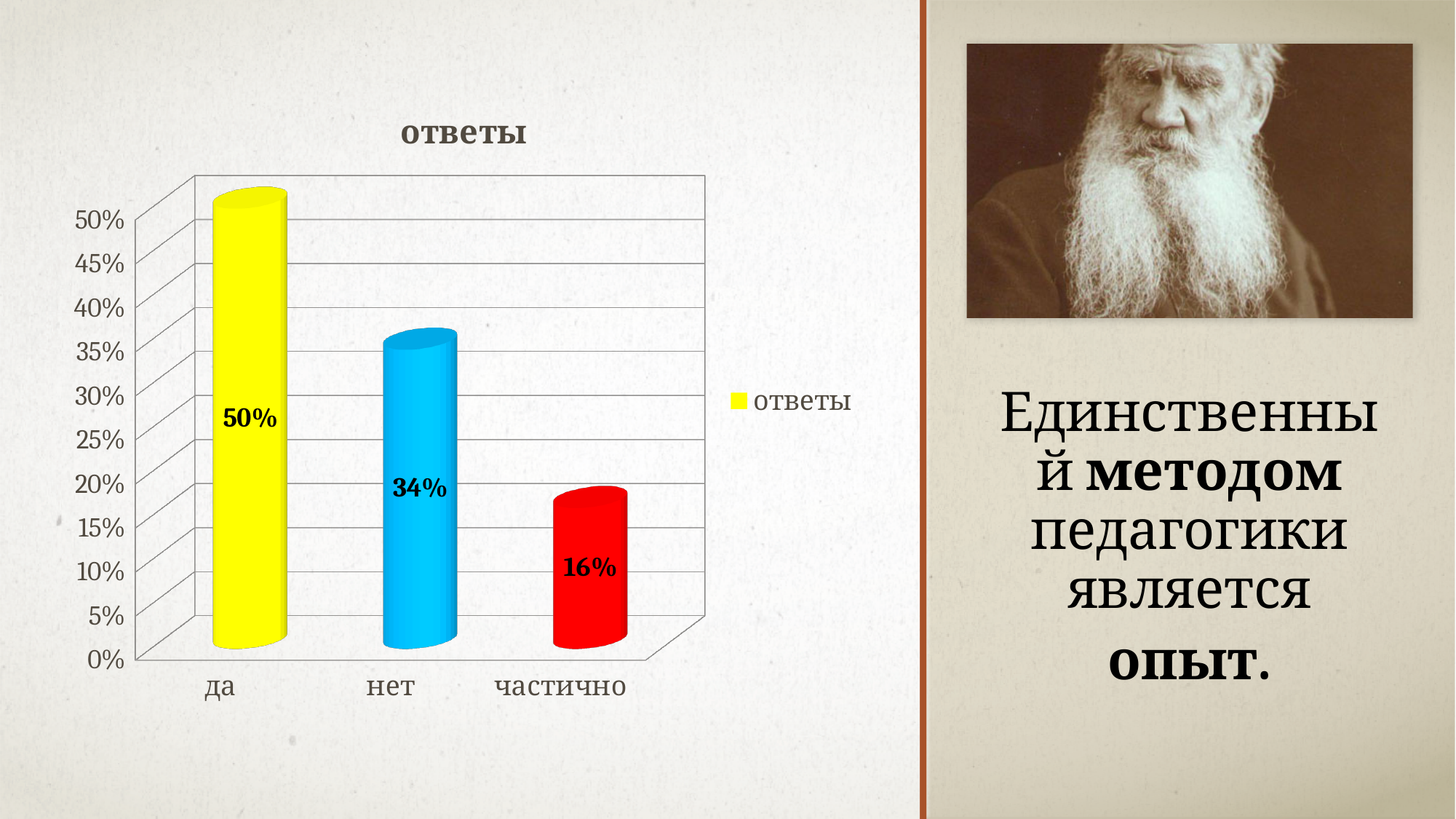
What is the value for "частично"? 16% What kind of chart is shown? bar chart What is the title of the chart? ответы Which is larger, the value for "нет" or the value for "частично"? нет How many series does the legend list? 1 What is the value for "да"? 50% What is the difference between the values for "да" and "нет"? 16% How many categories are shown on the x axis? 3 Which category has the highest value? да What is the value for "нет"? 34% What is the difference between the values for "нет" and "частично"? 18% Which category has the lowest value? частично